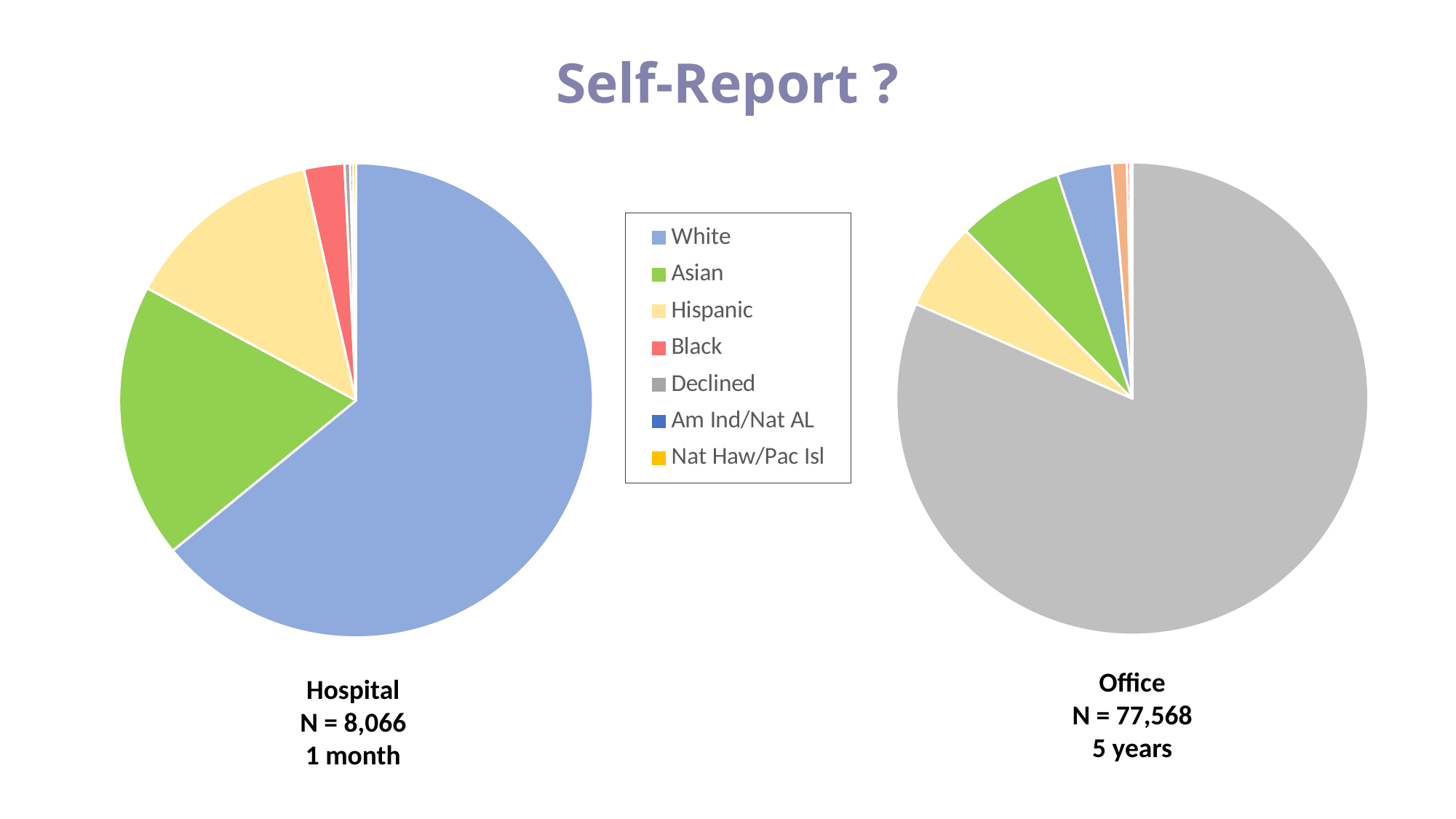
In the Office chart, which slice is larger, Declined or Hispanic? Declined How many categories does the legend list? 7 What kind of chart is the Hospital chart? pie chart What is the N shown under the Hospital chart? N = 8,066 What is the N shown under the Office chart? N = 77,568 In the Hospital chart, which slice is larger, White or Declined? White In the Hospital chart, which slice is larger, Asian or Black? Asian How many pie charts are shown on the slide? 2 In the Hospital chart, which category has the largest slice? White In the Office chart, which category has the largest slice? Declined